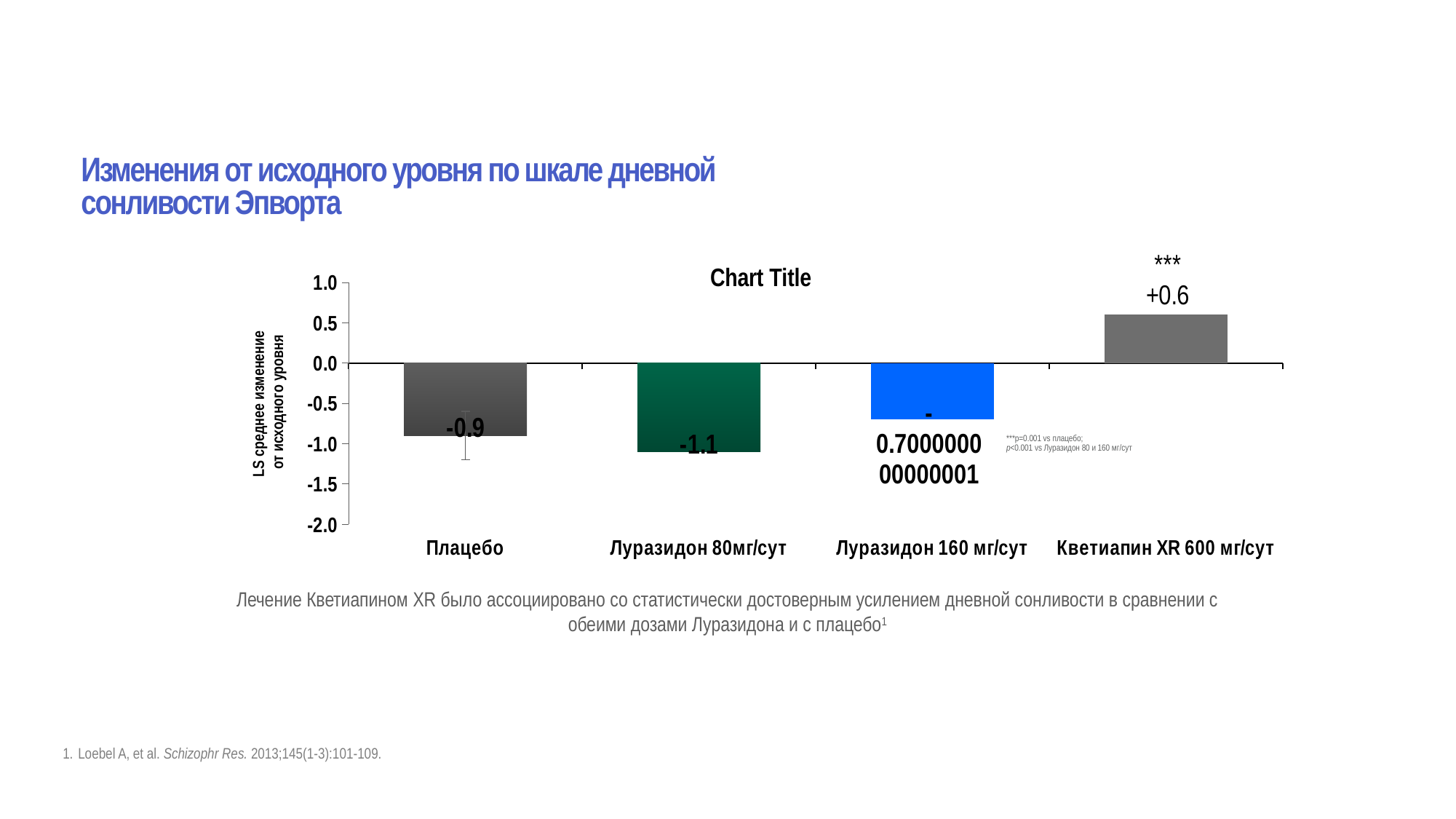
What is the value for Луразидон 80мг/сут? -1.1 Which is larger, the value for Плацебо or the value for Луразидон 80мг/сут? Плацебо What is the value for Кветиапин XR 600 мг/сут? +0.6 Is the value for Луразидон 160 мг/сут greater or less than -1.0? greater What kind of chart is shown on the slide? bar chart How many categories are shown on the x axis? 4 What is the value for Плацебо? -0.9 Which category has the lowest value? Луразидон 80мг/сут Which category has the highest value? Кветиапин XR 600 мг/сут What is the difference between the values for Плацебо and Луразидон 80мг/сут? 0.2 What is the title printed above the chart? Chart Title What is the difference between the values for Кветиапин XR 600 мг/сут and Плацебо? 1.5